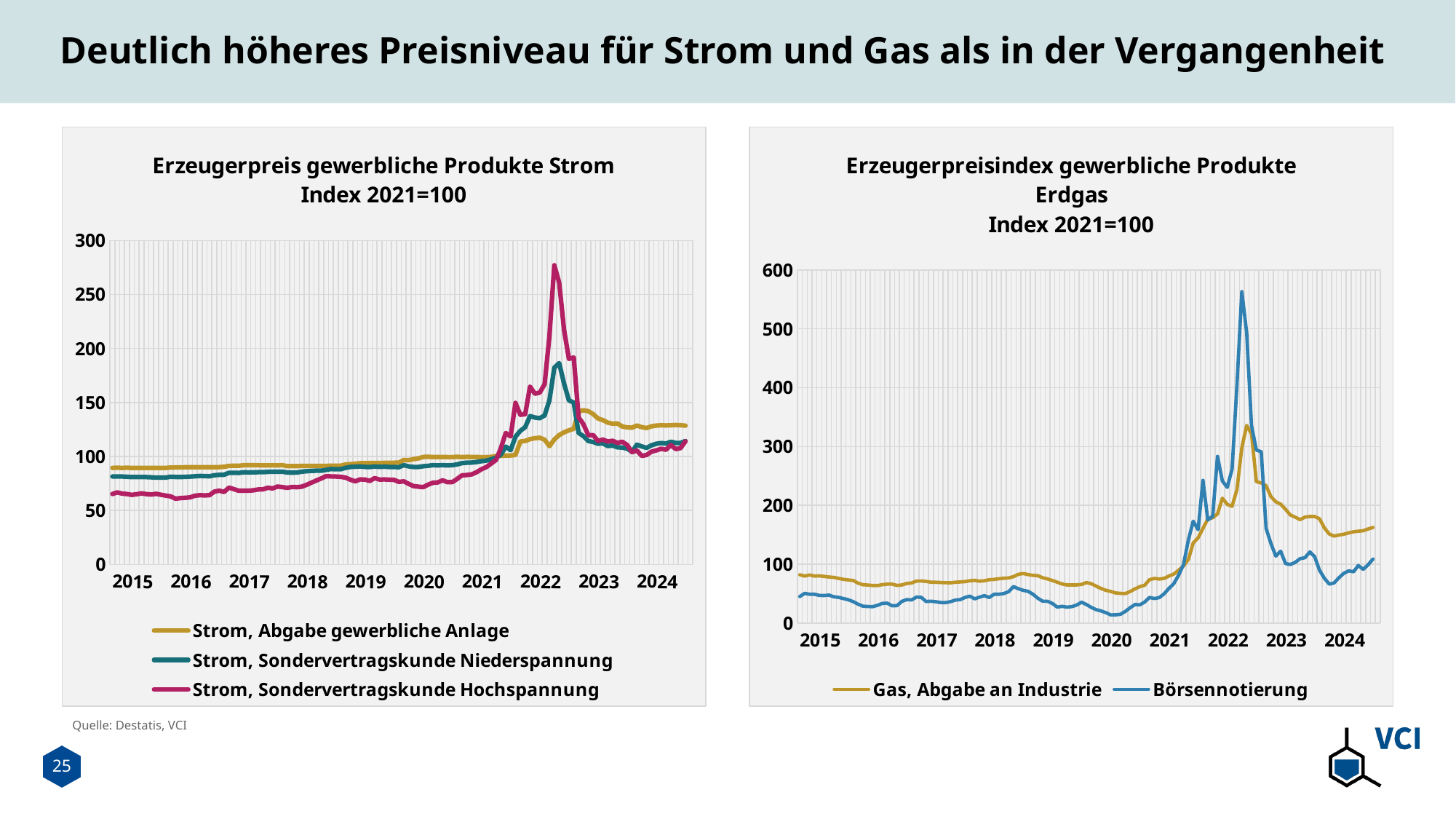
How many year labels are shown on the x axis of the left chart (Strom)? 10 In the right chart (Erdgas), is the peak value of 'Börsennotierung' greater or less than 500? greater What is the base year of the index used in both charts, as stated in their titles? 2021=100 In the left chart (Strom), which series reaches the highest peak? Strom, Sondervertragskunde Hochspannung In the right chart (Erdgas), which series reaches the highest peak? Börsennotierung In the left chart (Strom), is the peak value of 'Strom, Sondervertragskunde Hochspannung' greater or less than 250? greater In the right chart (Erdgas), is the peak value of 'Gas, Abgabe an Industrie' greater or less than 300? greater What kind of chart is the left chart, 'Erzeugerpreis gewerbliche Produkte Strom'? Line chart How many series does the legend of the right chart (Erdgas) list? 2 How many series does the legend of the left chart (Strom) list? 3 In the right chart (Erdgas), does 'Börsennotierung' rise or fall from its 2022 peak to 2023? fall